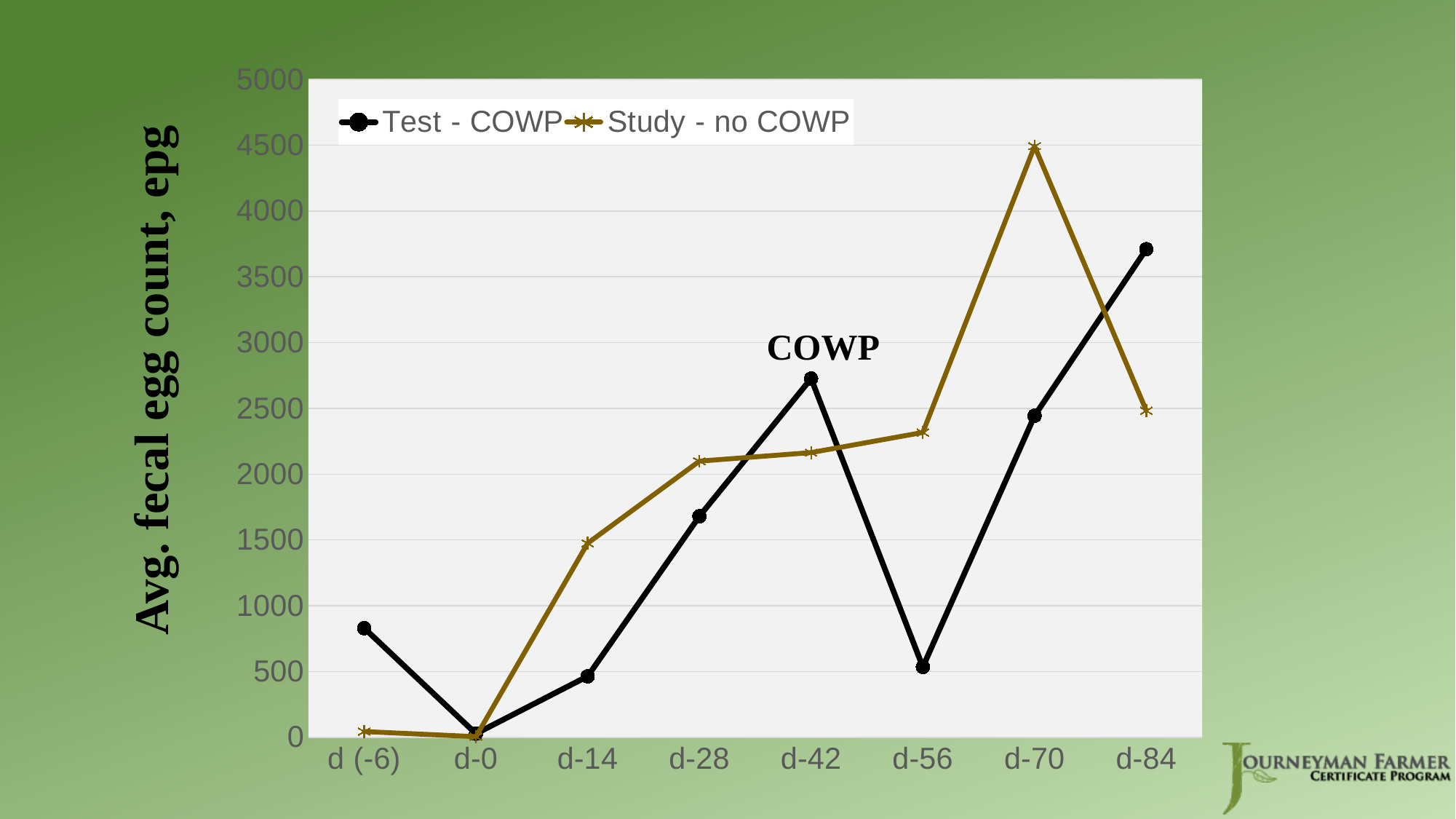
At which time point does the Test - COWP series reach its highest value? d-84 Is the value for Study - no COWP at d-70 greater or less than 4000? greater At which time point is the Test - COWP series at its lowest value? d-0 What kind of chart is shown on the slide? line chart At d-84, which series has the higher value, Test - COWP or Study - no COWP? Test - COWP How many time points are plotted along the x axis? 8 Is the value for Test - COWP at d-42 greater or less than 2500? greater Is the value for Test - COWP at d-56 greater or less than 1000? less At which time point does the Study - no COWP series reach its highest value? d-70 At d-14, which series has the higher value, Test - COWP or Study - no COWP? Study - no COWP How many series does the legend list? 2 What is the title of the y axis? Avg. fecal egg count, epg